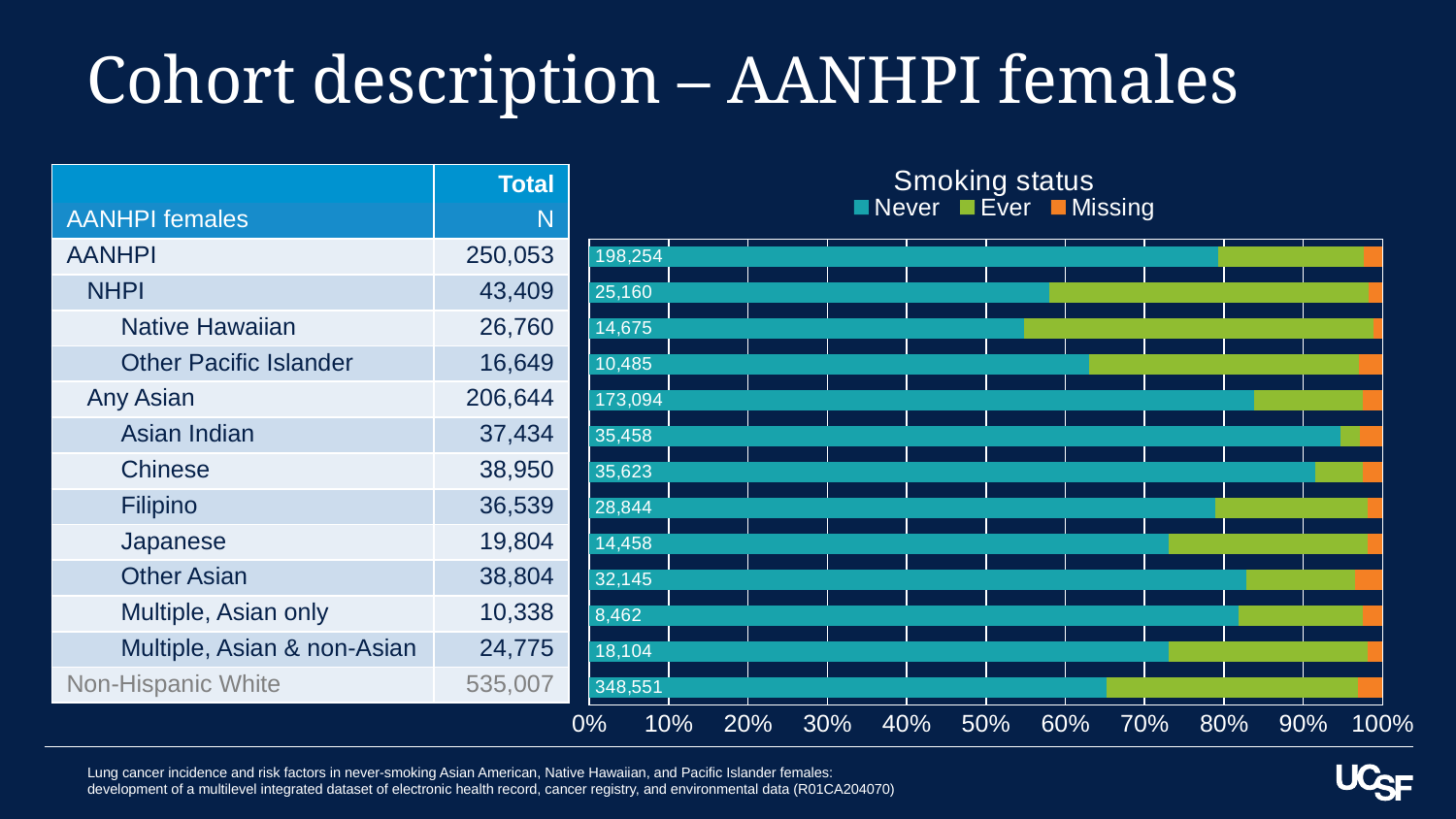
In the "Smoking status" chart, which bar has the largest printed Never value? Non-Hispanic White (348,551) In the "Smoking status" chart, what value is printed on the Never segment of the bottom bar (Non-Hispanic White row)? 348,551 In the "Smoking status" chart, what is the difference between the Never values printed for the AANHPI bar (198,254) and the Any Asian bar (173,094)? 25,160 In the "Smoking status" chart, what value is printed on the Never segment of the bar aligned with the Japanese row? 14,458 In the "Smoking status" chart, is the Never share of the bar aligned with the Native Hawaiian row greater or less than 60%? less In the "Smoking status" chart, what value is printed on the Never segment of the top bar (AANHPI row)? 198,254 What are the three legend entries of the "Smoking status" chart? Never, Ever, Missing What kind of chart is shown under the title "Smoking status"? bar chart How many bars are plotted in the "Smoking status" chart? 13 In the "Smoking status" chart, which bar has the smallest printed Never value? Multiple, Asian only (8,462) In the "Smoking status" chart, is the Never share of the top bar (AANHPI row) greater or less than 70%? greater How many series does the legend of the "Smoking status" chart list? 3